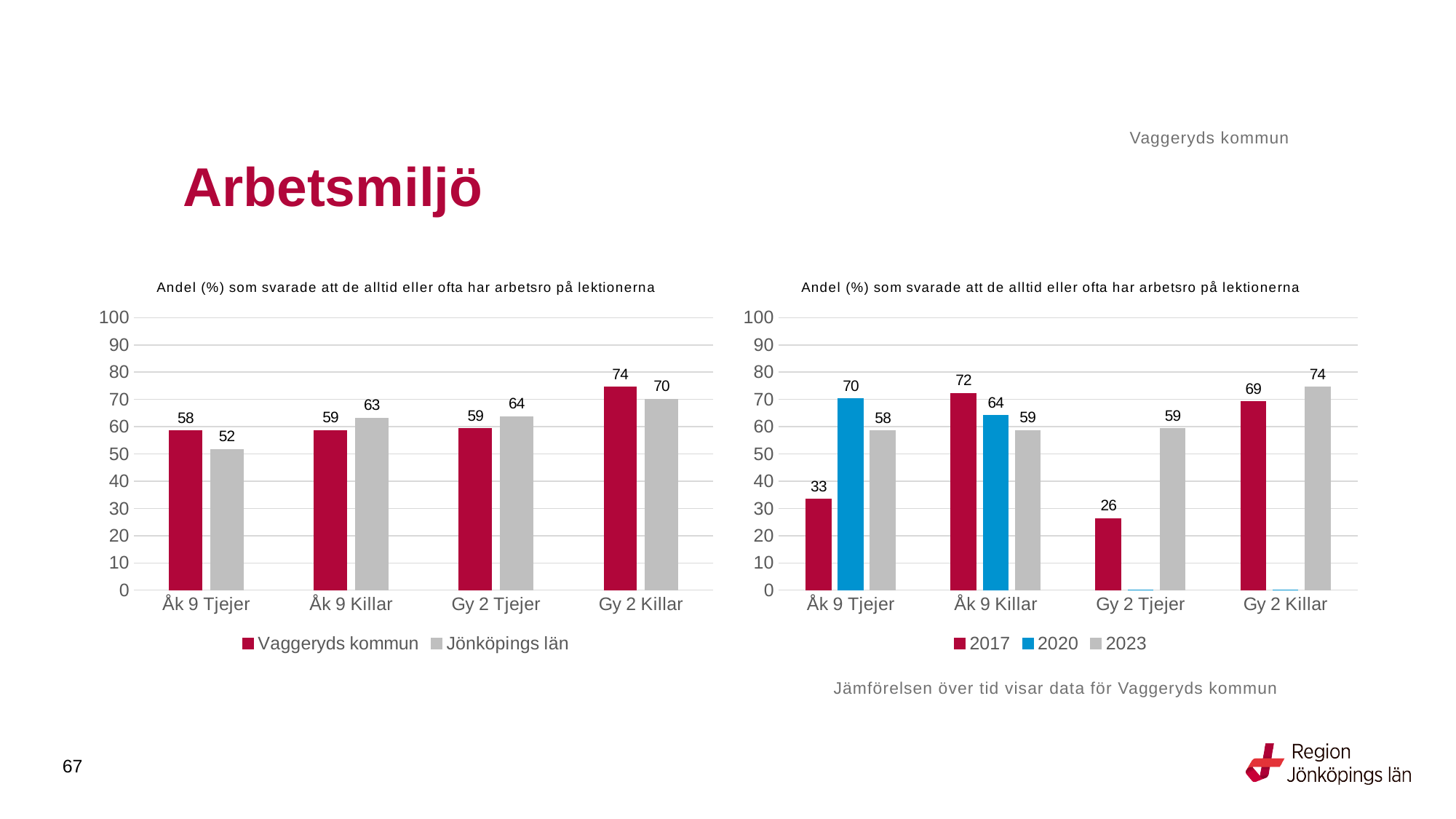
In the left chart, what is the value for Jönköpings län for Åk 9 Tjejer? 52 In the left chart, which is larger for Gy 2 Tjejer: Vaggeryds kommun or Jönköpings län? Jönköpings län How many series does the legend of the right chart list? 3 In the right chart, which category has the lowest 2017 value? Gy 2 Tjejer In the left chart, what is the value for Vaggeryds kommun for Gy 2 Killar? 74 How many series does the legend of the left chart list? 2 In the left chart, which category has the highest value for Jönköpings län? Gy 2 Killar In the right chart, what is the difference between the 2023 and 2017 values for Åk 9 Tjejer? 25 What type of chart is the right chart? Bar chart In the left chart, what is the difference between Vaggeryds kommun and Jönköpings län for Åk 9 Killar? 4 In the right chart, what is the 2017 value for Gy 2 Tjejer? 26 In the right chart, what is the 2020 value for Åk 9 Tjejer? 70